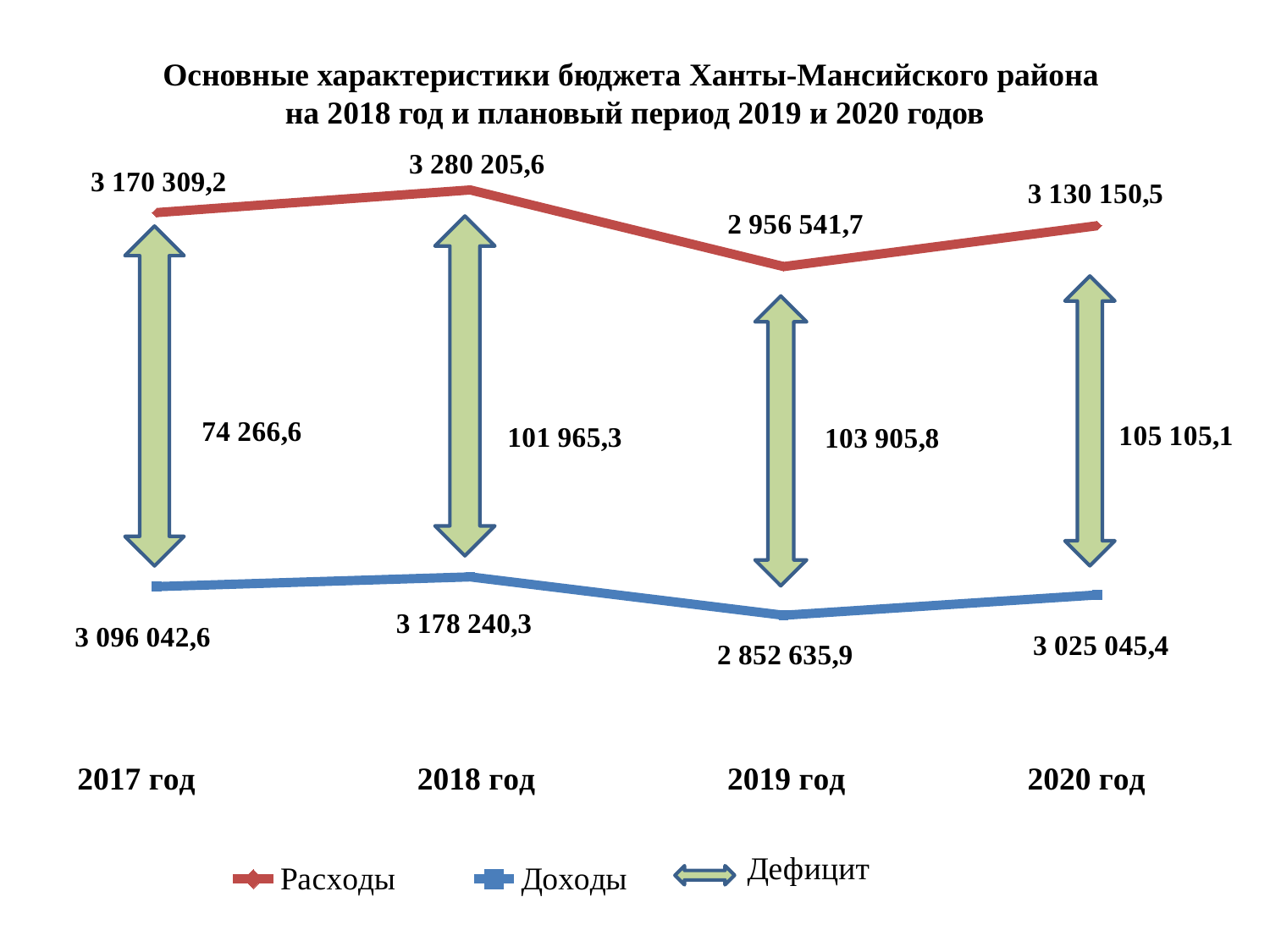
How many years are shown on the x axis? 4 What is the value of Доходы for 2017 год? 3 096 042,6 Which is larger in 2020 год, Расходы or Доходы? Расходы In which year is Расходы the highest? 2018 год Does the Дефицит rise or fall from 2017 год to 2020 год? rise How many entries does the legend list? 3 What is the Дефицит shown for 2020 год? 105 105,1 What is the difference between Расходы and Доходы in 2017 год? 74 266,6 In which year is Доходы the lowest? 2019 год What kind of chart is this? line chart What is the value of Расходы for 2018 год? 3 280 205,6 What is the value of Доходы for 2019 год? 2 852 635,9